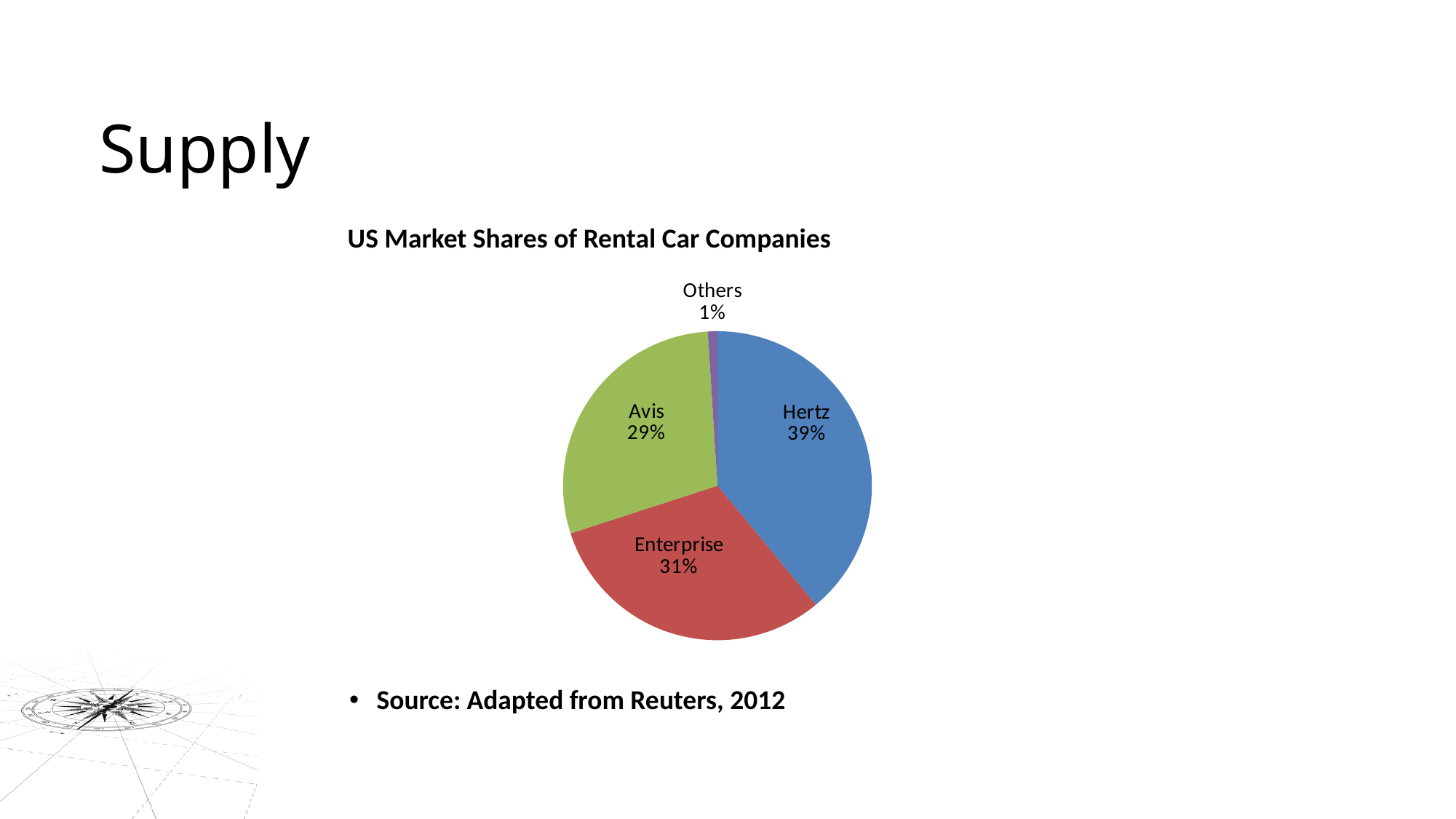
What is the difference in market share between Hertz and Avis? 10% What kind of chart is shown on the slide? pie chart What is the market share of Others? 1% What is the market share of Hertz? 39% What is the market share of Enterprise? 31% What colour is the Enterprise slice? red Which slice has the smallest share? Others What is the market share of Avis? 29% How many slices does the pie chart have? 4 Which has a larger market share, Enterprise or Avis? Enterprise What is the title of the chart? US Market Shares of Rental Car Companies Which company has the largest market share? Hertz